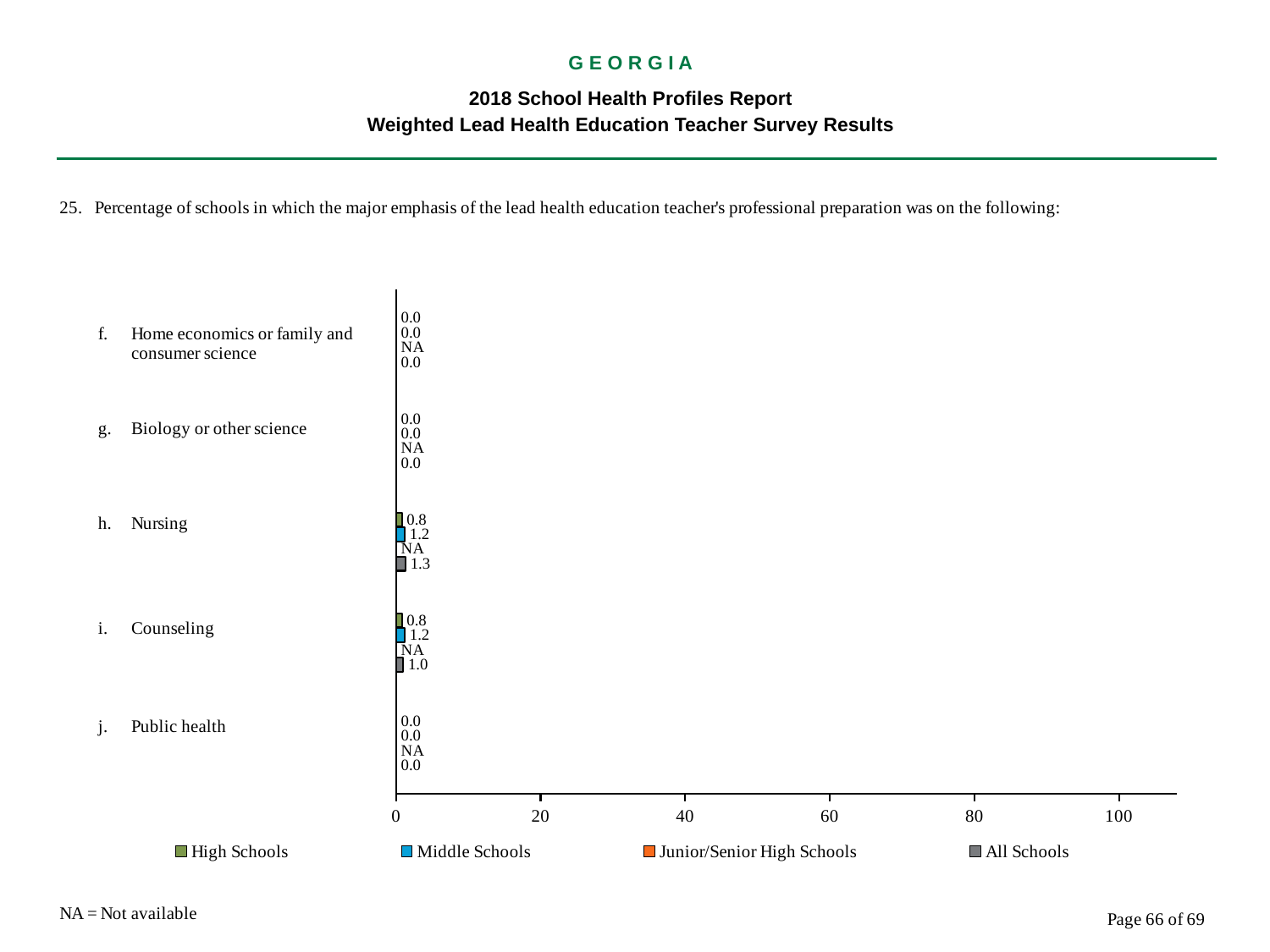
Which category has the highest All Schools value? Nursing What is the value for Nursing in the High Schools series? 0.8 What does NA stand for according to the note on the slide? Not available What is the value for Public health in the All Schools series? 0.0 How many series does the legend list? 4 What is the difference between the All Schools values for Nursing and Counseling? 0.3 What is the value for Counseling in the Middle Schools series? 1.2 What is shown for Biology or other science in the Junior/Senior High Schools series? NA What is the value for Nursing in the All Schools series? 1.3 What kind of chart is shown on the slide? Bar chart How many categories are shown on the chart? 5 Which is larger for Nursing: the High Schools value or the Middle Schools value? Middle Schools